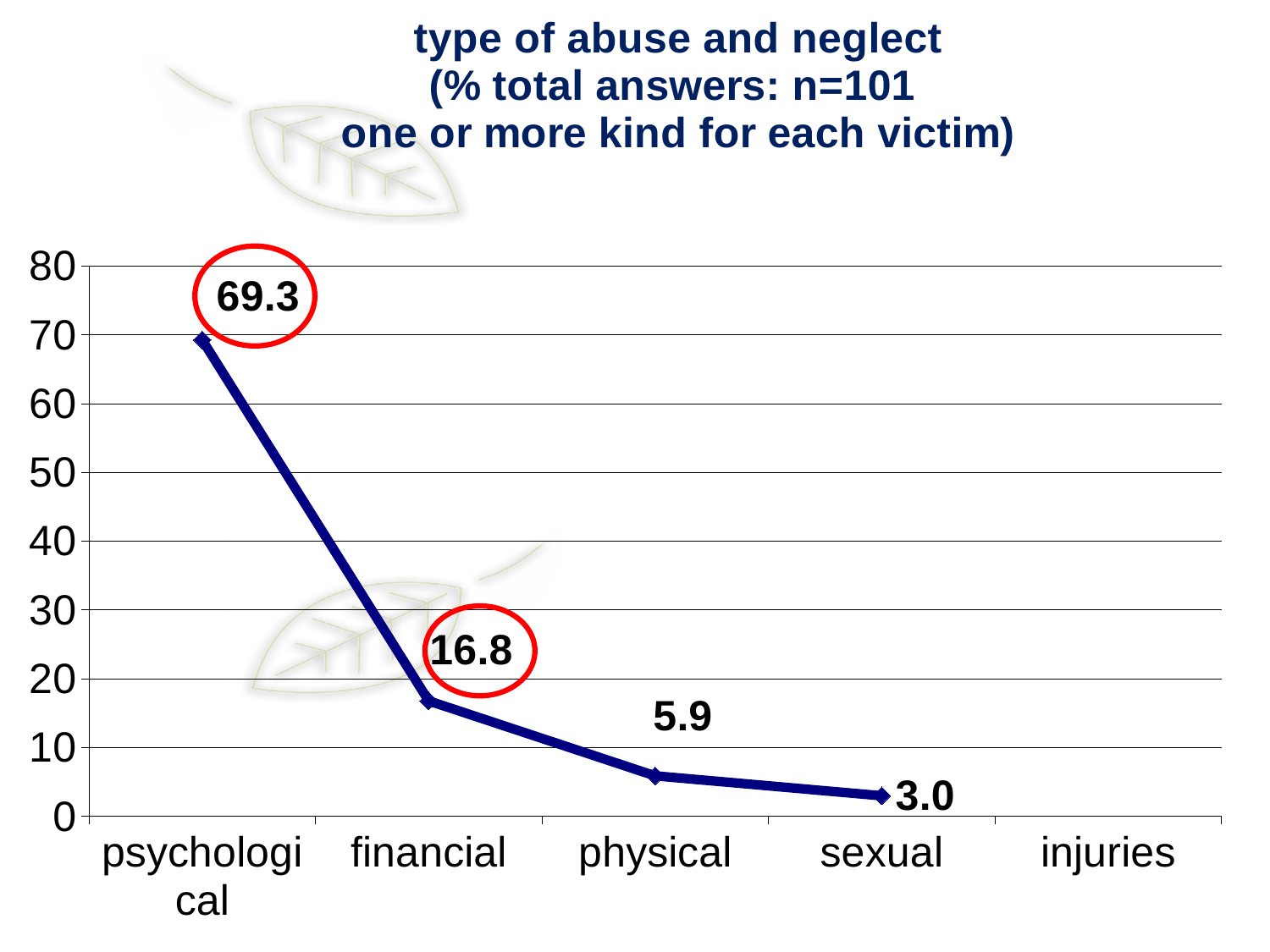
What kind of chart is shown on the slide? line chart Which two data labels are circled in red on the chart? 69.3 and 16.8 What is the value for psychological? 69.3 What is the value for financial? 16.8 Do the values rise or fall from left to right along the x axis? fall What is the difference between the values for psychological and financial? 52.5 Which of the plotted categories has the lowest value? sexual Which is larger, the value for financial or the value for physical? financial What is the value for sexual? 3.0 Which category has the highest value? psychological What is the value for physical? 5.9 How many category labels are shown on the x axis? 5